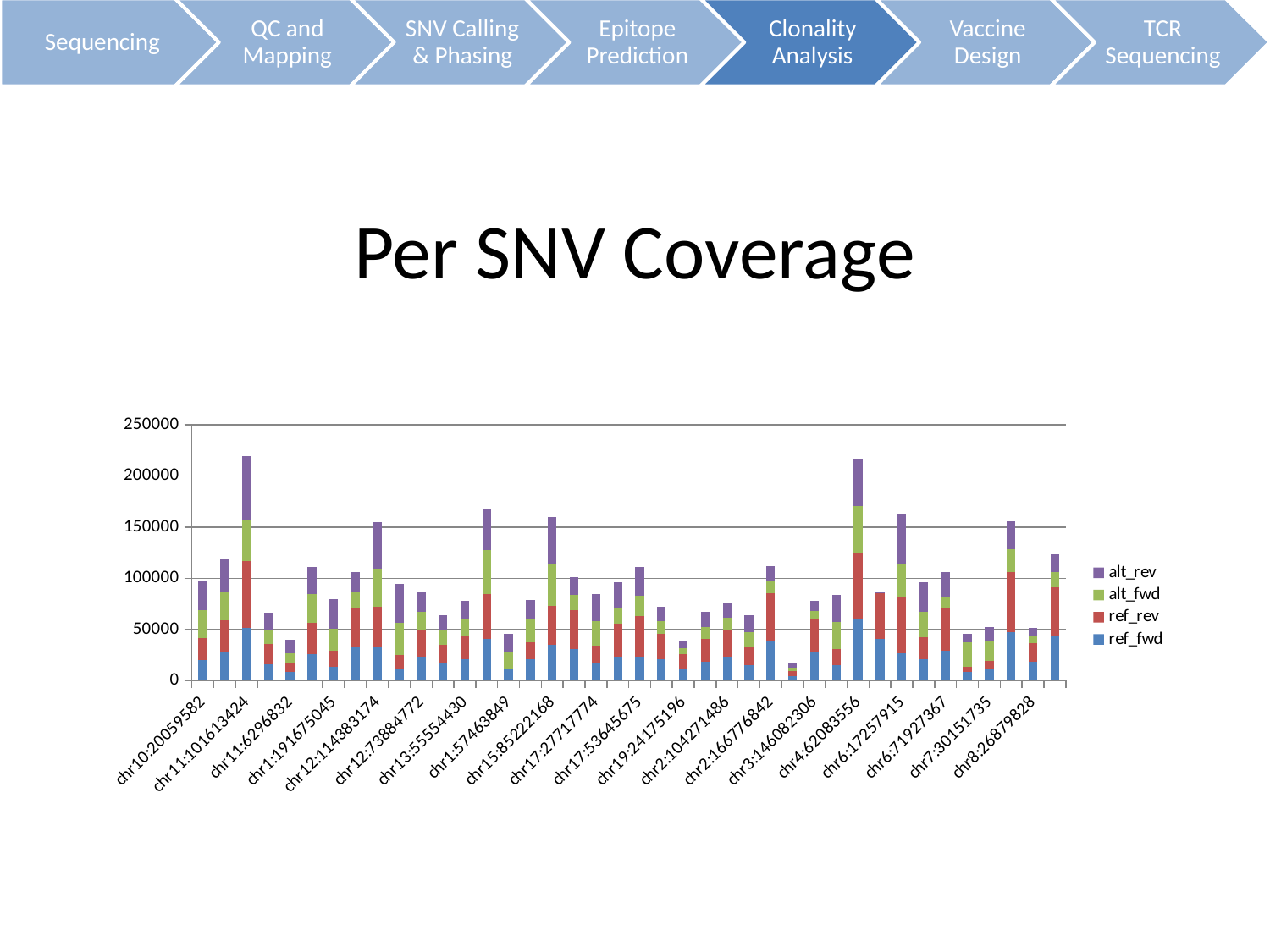
Is the total coverage for chr4:62083556 greater or less than 200000? greater What is the highest value shown on the y axis? 250000 Which series is shown in purple at the top of each stacked bar? alt_rev What kind of chart is shown on the slide? stacked bar chart Is the total coverage for chr19:24175196 greater or less than 50000? less How many series does the legend list? 4 What is the title of the chart? Per SNV Coverage Is the total coverage for chr6:17257915 greater or less than 150000? greater Which has the larger total coverage, chr11:101613424 or chr11:6296832? chr11:101613424